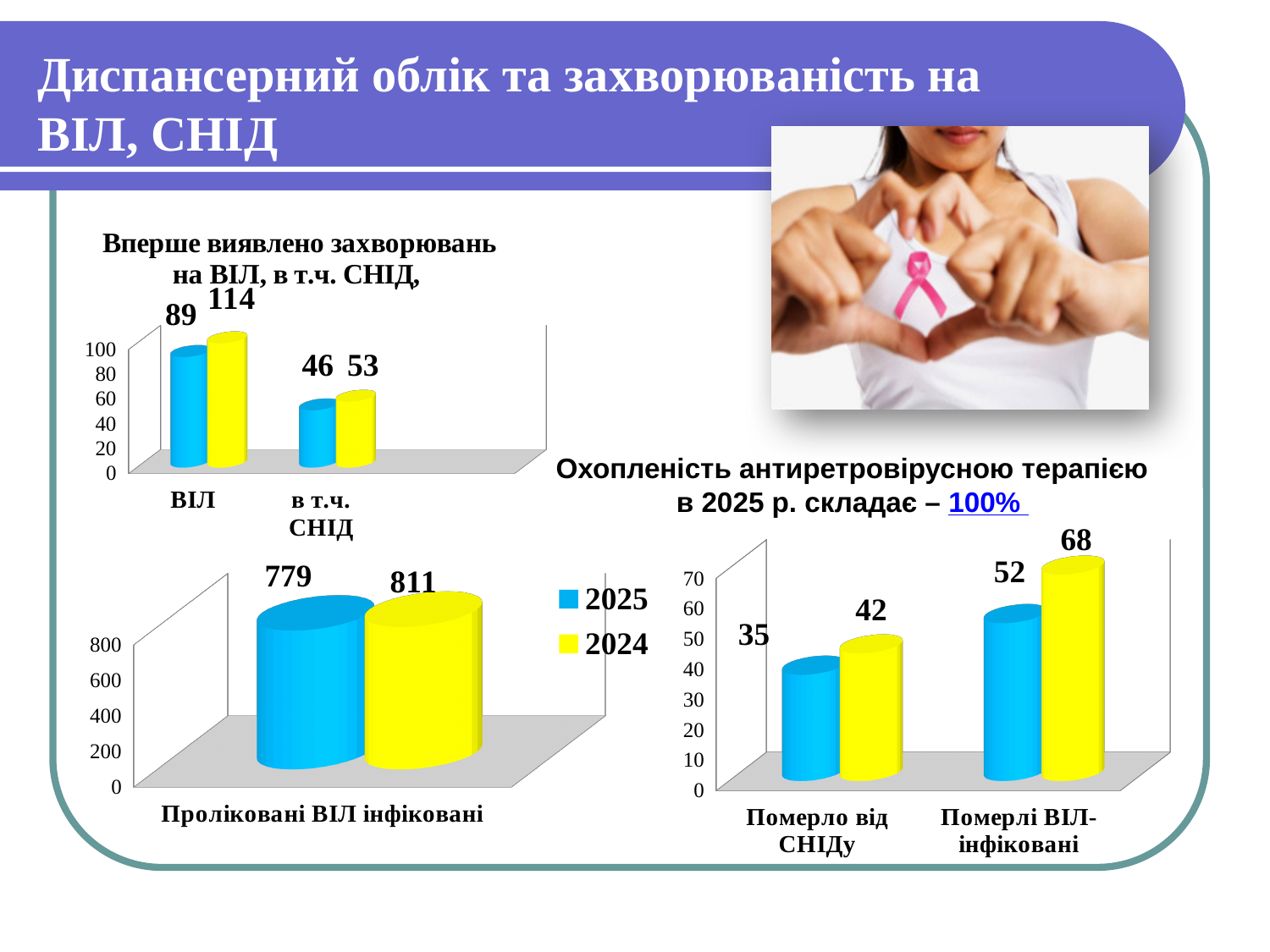
In the top-left chart, which is larger for в т.ч. СНІД: the 2025 value or the 2024 value? 2024 In the bottom-right chart, what is the value for Померло від СНІДу in 2024? 42 How many series does the legend list? 2 In the bottom-left chart "Проліковані ВІЛ інфіковані", what is the difference between the 2024 and 2025 values? 32 In the top-left chart, what is the value for в т.ч. СНІД in 2025? 46 What kind of chart is the bottom-right chart? Bar chart In the bottom-right chart, what is the value for Померлі ВІЛ-інфіковані in 2025? 52 In the bottom-right chart, which category has the highest value? Померлі ВІЛ-інфіковані In the top-left chart titled "Вперше виявлено захворювань на ВІЛ, в т.ч. СНІД", what is the value for ВІЛ in 2024 (yellow bar)? 114 In the bottom-left chart "Проліковані ВІЛ інфіковані", what is the value for 2025? 779 In the top-left chart titled "Вперше виявлено захворювань на ВІЛ, в т.ч. СНІД", what is the value for ВІЛ in 2025 (blue bar)? 89 In the top-left chart, what is the difference between the 2024 and 2025 values for ВІЛ? 25